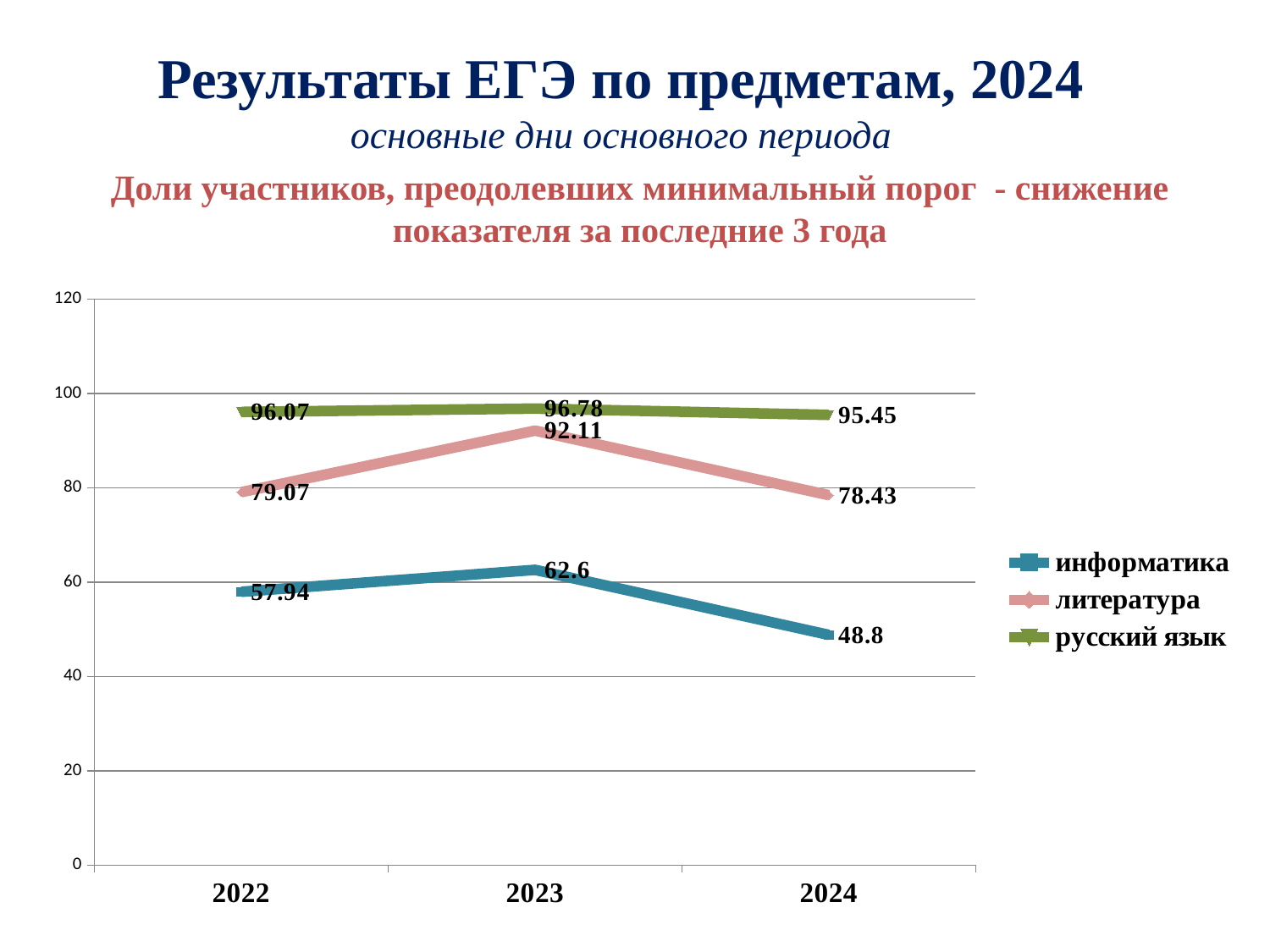
What is the value for литература in 2023? 92.11 What is the value for информатика in 2024? 48.8 What is the value for русский язык in 2022? 96.07 How many years are shown on the x axis? 3 In which year is the value for литература highest? 2023 What kind of chart is shown on the slide? line chart Which is larger in 2024: the value for литература or the value for информатика? литература Is the value for русский язык in 2024 greater or less than 80? greater How many series does the legend list? 3 What is the difference between the информатика values in 2023 and 2024? 13.8 Does the value for информатика rise or fall from 2023 to 2024? fall In which year is the value for информатика lowest? 2024